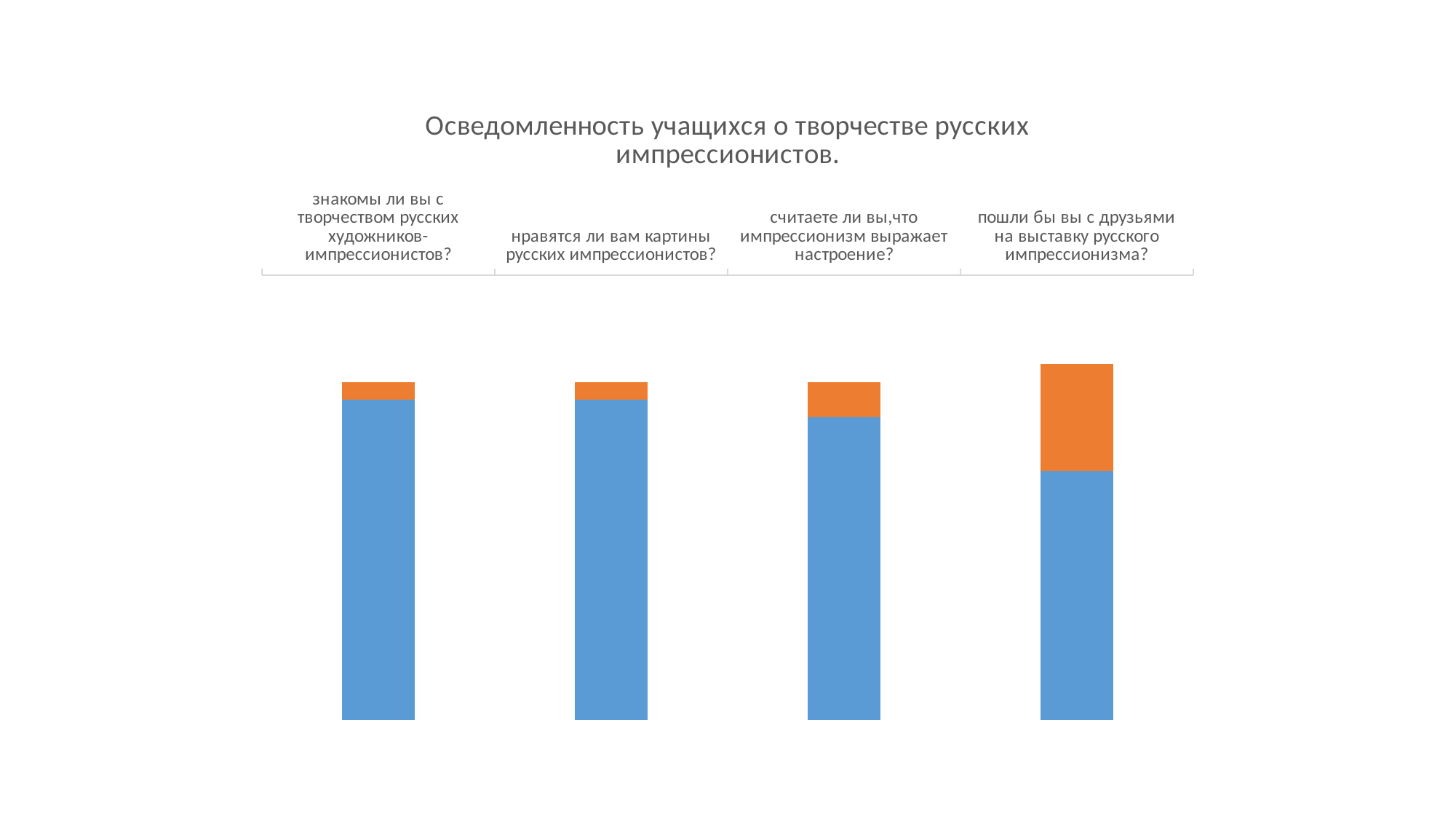
What is the title of the chart? Осведомленность учащихся о творчестве русских импрессионистов. In each bar, which colour segment is larger, blue or orange? Blue Which category has the largest orange segment? пошли бы вы с друзьями на выставку русского импрессионизма? Is the orange segment larger for "считаете ли вы,что импрессионизм выражает настроение?" or for "нравятся ли вам картины русских импрессионистов?"? считаете ли вы,что импрессионизм выражает настроение? How many categories (questions) are shown along the x axis of the chart? 4 Which category is the fourth (rightmost) on the x axis? пошли бы вы с друзьями на выставку русского импрессионизма? Is the blue segment larger for "знакомы ли вы с творчеством русских художников-импрессионистов?" or for "пошли бы вы с друзьями на выставку русского импрессионизма?"? знакомы ли вы с творчеством русских художников-импрессионистов? What kind of chart is shown on the slide? Stacked bar chart How many colour segments does each stacked bar contain? 2 Which category has the smallest blue segment? пошли бы вы с друзьями на выставку русского импрессионизма?